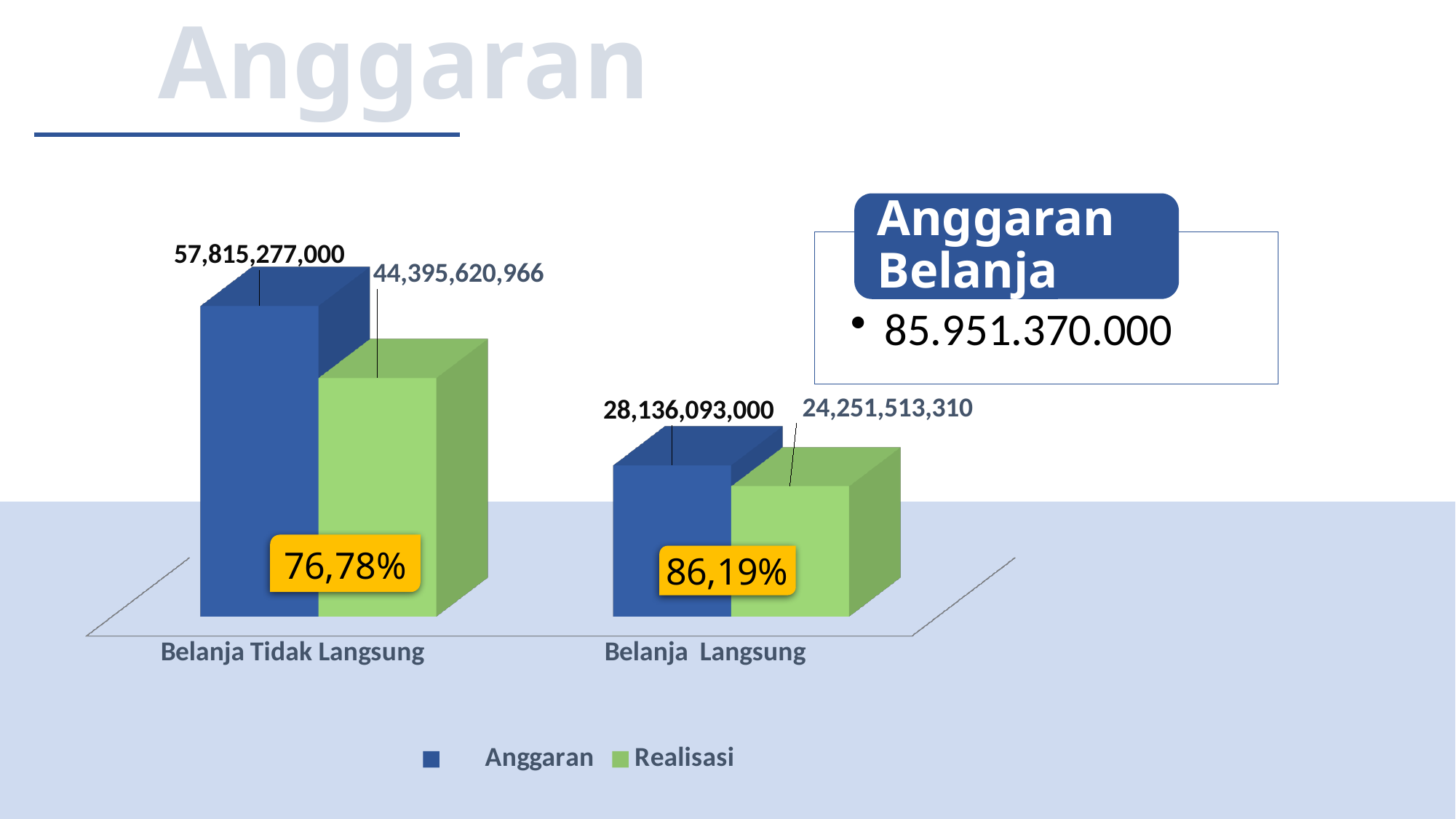
What is the Realisasi value for Belanja Tidak Langsung? 44,395,620,966 How many series does the chart legend list? 2 What is the Anggaran value for Belanja Tidak Langsung? 57,815,277,000 What is the difference between the Anggaran and Realisasi values for Belanja Tidak Langsung? 13,419,656,034 Which category has the highest Anggaran value? Belanja Tidak Langsung What is the difference between the Anggaran values for Belanja Tidak Langsung and Belanja Langsung? 29,679,184,000 How many categories are shown on the x axis of the chart? 2 What is the Anggaran value for Belanja Langsung? 28,136,093,000 What kind of chart is shown on the slide? Bar chart Which is larger for Belanja Langsung, the Anggaran value or the Realisasi value? Anggaran What is the Realisasi value for Belanja Langsung? 24,251,513,310 Which category has the lowest Realisasi value? Belanja Langsung